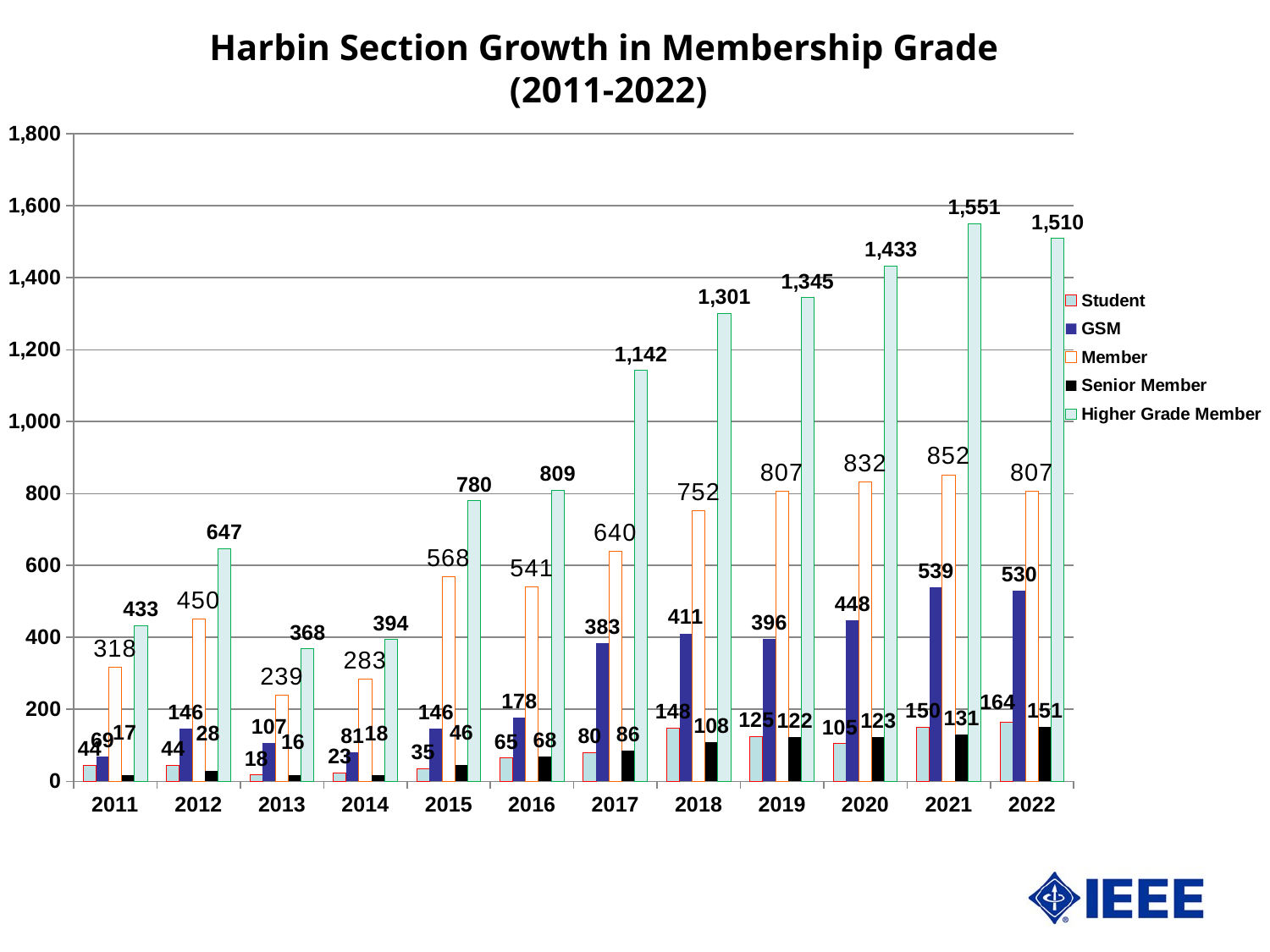
How many series does the legend list? 5 What is the value for Senior Member in 2022? 151 In which year is the Higher Grade Member value highest? 2021 What kind of chart is shown on the slide? Bar chart What is the value for GSM in 2017? 383 How many years are shown on the x axis? 12 Which is larger, the Member value in 2021 or the Member value in 2022? 2021 What is the value for Higher Grade Member in 2021? 1,551 Is the Higher Grade Member value for 2017 greater or less than 1,000? greater What is the difference between the Higher Grade Member values in 2022 and 2011? 1,077 In which year is the Higher Grade Member value lowest? 2013 What is the value for Member in 2020? 832